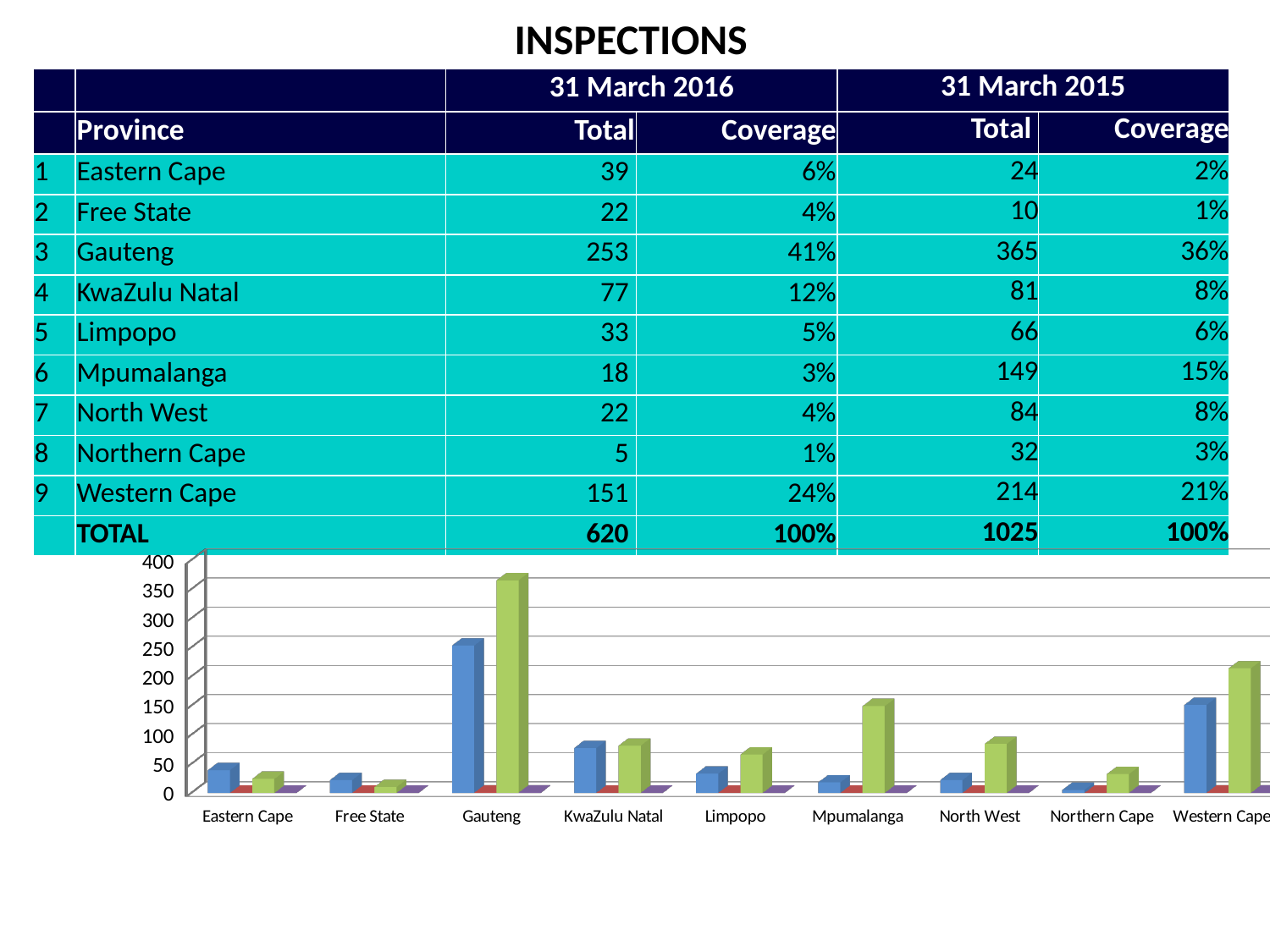
Which province has the tallest blue bar in the chart? Gauteng Which province has the tallest bar in the chart? Gauteng Is the green bar for Mpumalanga greater or less than 100? greater Which province has the shortest blue bar in the chart? Northern Cape Is the green bar for Gauteng greater or less than 300? greater Is the green bar for Limpopo greater or less than 100? less For Gauteng, which is taller: the blue bar or the green bar? the green bar How many provinces are shown on the x axis of the chart? 9 What is the highest value shown on the chart's vertical axis? 400 What kind of chart is shown below the table? bar chart